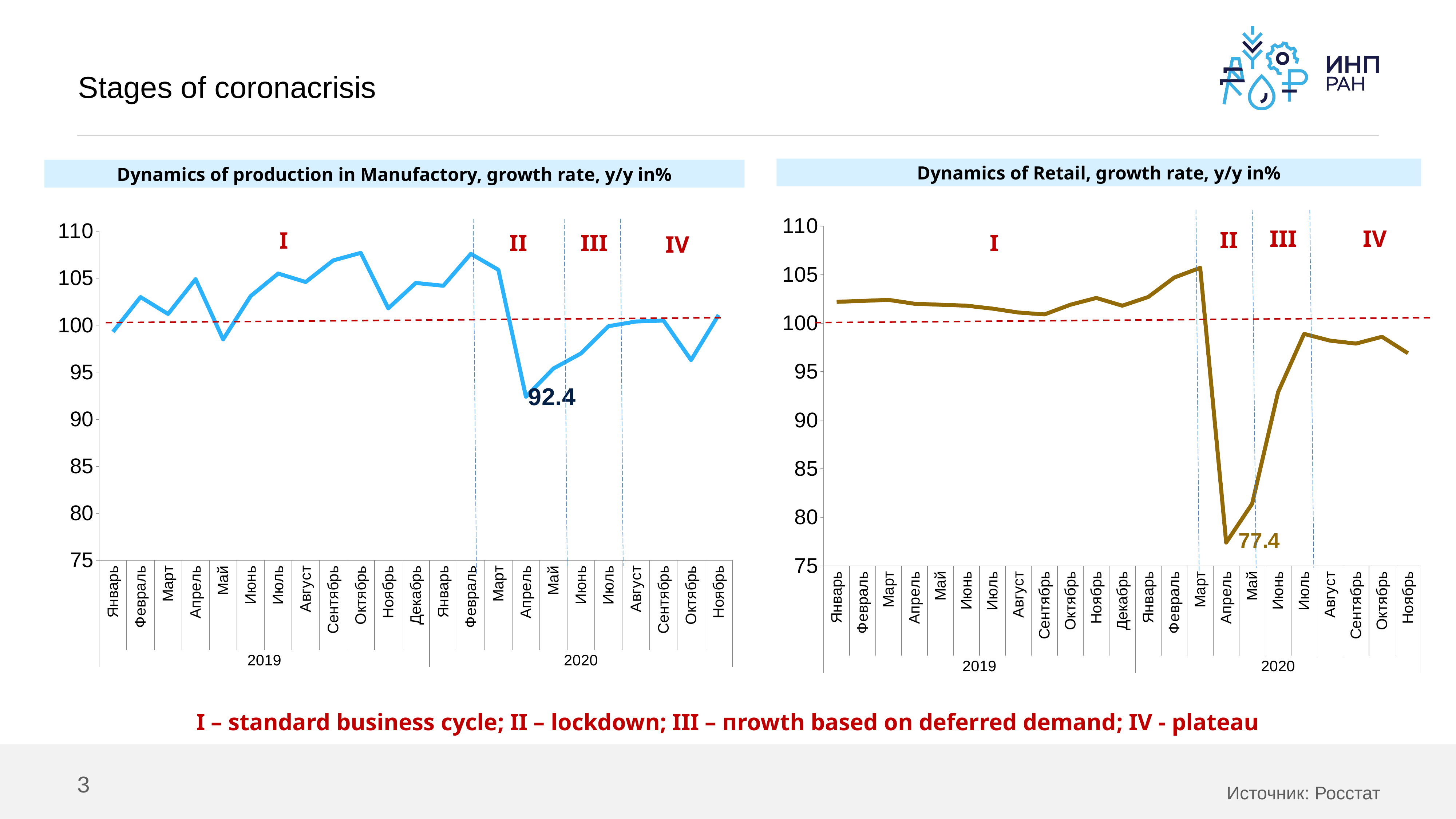
In the 'Dynamics of Retail' chart, does the line rise or fall from Март 2020 to Апрель 2020? fall What is the difference between the labelled minimum of the Manufactory chart (92.4) and the labelled minimum of the Retail chart (77.4)? 15.0 In the 'Dynamics of Retail' chart, is the value for Октябрь 2019 greater or less than 100? greater In the 'Dynamics of Retail' chart, what value is labelled at the lowest point of the line (April 2020)? 77.4 Which is larger: the labelled minimum in the Manufactory chart (92.4) or the labelled minimum in the Retail chart (77.4)? Manufactory (92.4) How many monthly data points are plotted in the 'Dynamics of production in Manufactory' chart? 23 In the 'Dynamics of production in Manufactory' chart, which month has the lowest value? Апрель 2020 In the 'Dynamics of production in Manufactory' chart, what value is labelled at the lowest point of the line (April 2020)? 92.4 In the 'Dynamics of Retail' chart, which month has the lowest value? Апрель 2020 In the 'Dynamics of production in Manufactory' chart, is the value for Октябрь 2020 greater or less than 100? less What kind of chart is the 'Dynamics of Retail, growth rate, y/y in%' chart? line chart How many stages (Roman numerals) are marked on each chart? 4